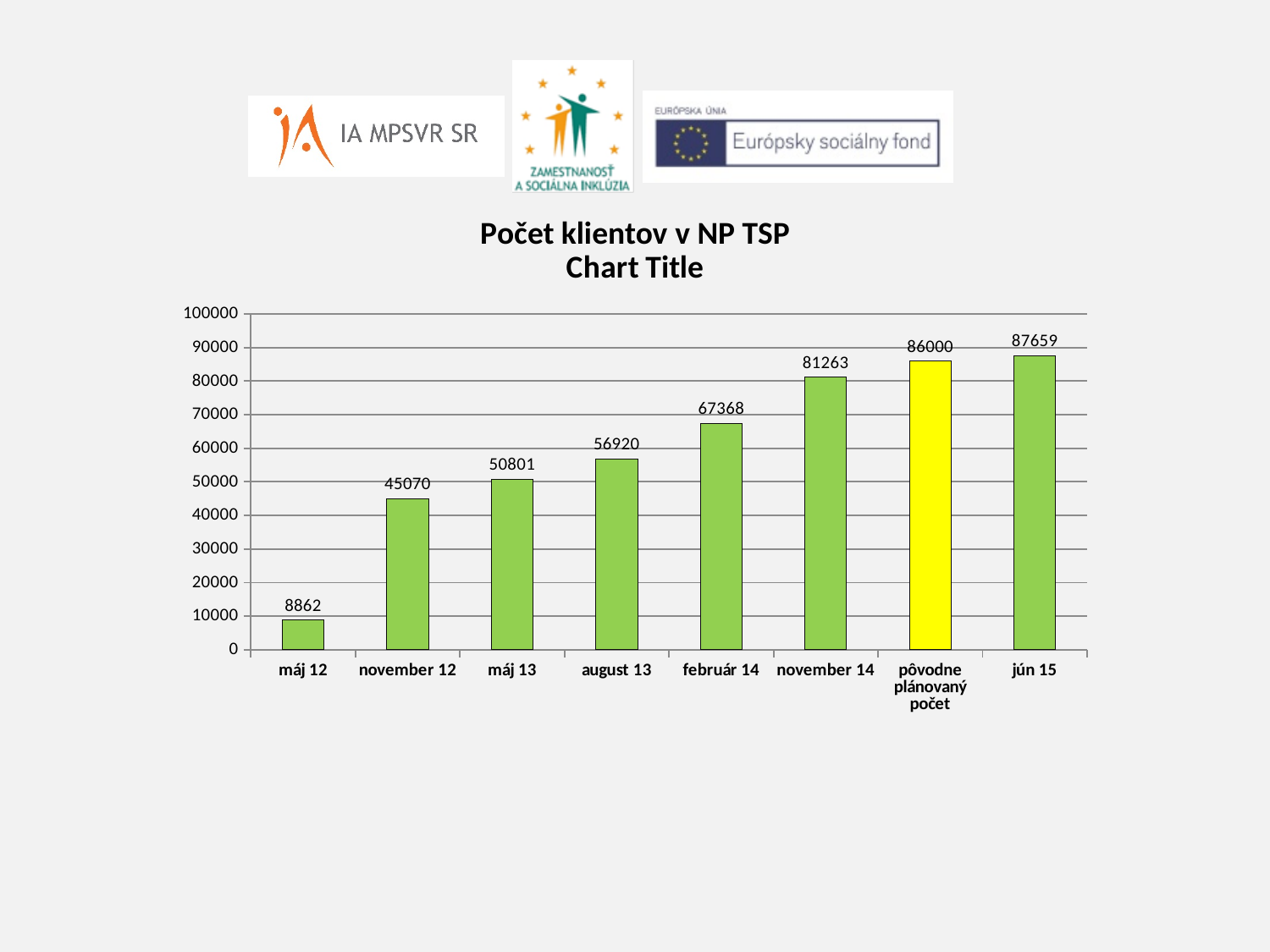
What is the value for pôvodne plánovaný počet? 86000 What kind of chart is shown on the slide? bar chart Which is larger, the value for august 13 or the value for máj 13? august 13 Which bar is coloured yellow instead of green? pôvodne plánovaný počet What is the value for máj 12? 8862 What is the difference between the values for november 12 and máj 12? 36208 How many categories are shown on the x axis? 8 Which category has the highest value? jún 15 What is the difference between the values for jún 15 and pôvodne plánovaný počet? 1659 Is the value for február 14 greater or less than 60000? greater What is the value for november 14? 81263 Which category has the lowest value? máj 12